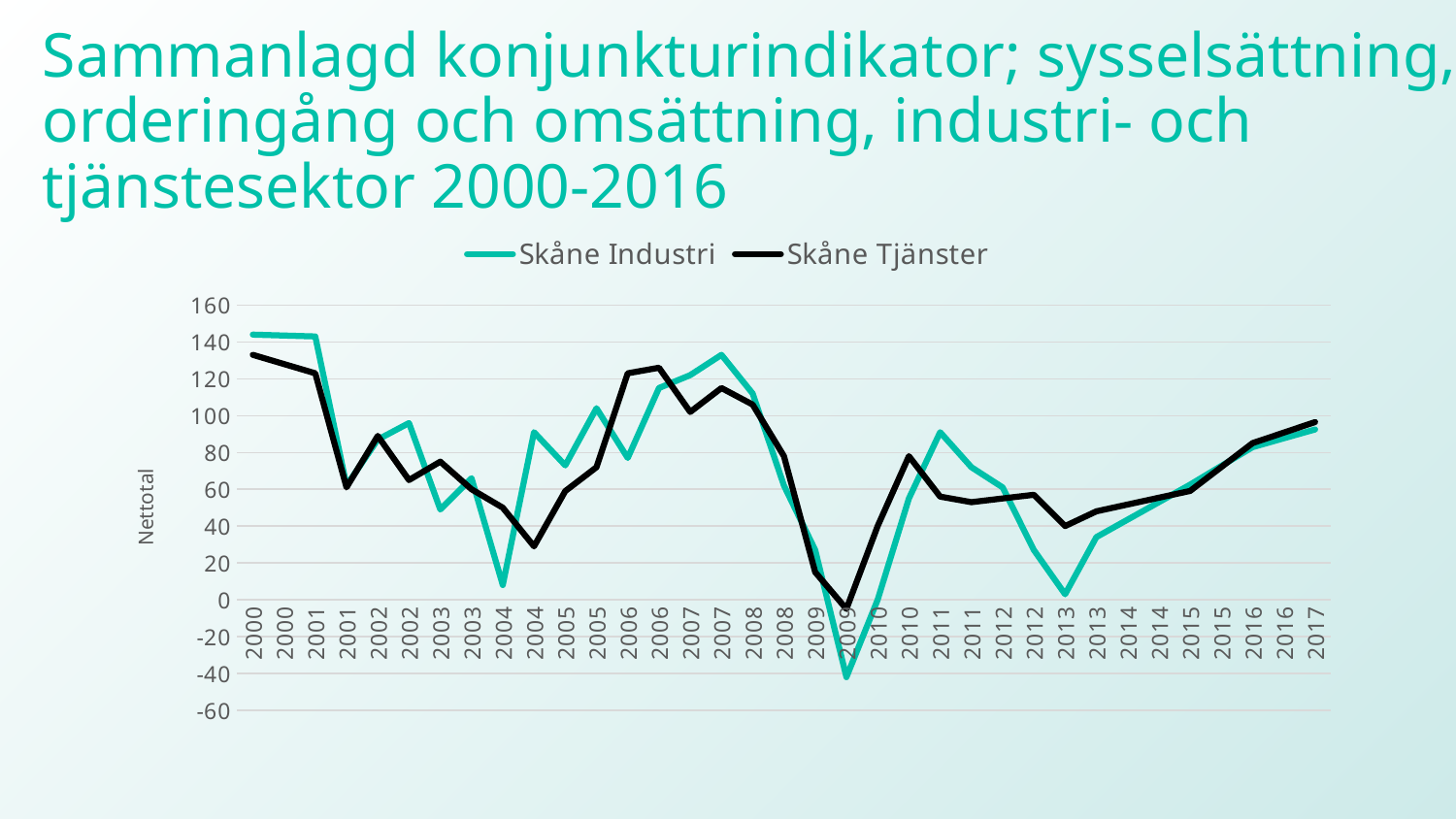
Is the value for Skåne Tjänster at the first 2000 point greater or less than 120? greater Is the value for Skåne Industri at the first 2013 point greater or less than 20? less At the second 2004 point, which series has the larger value, Skåne Industri or Skåne Tjänster? Skåne Industri What is the label on the vertical axis? Nettotal What kind of chart is shown on the slide? line chart Is the value for Skåne Industri at the second 2009 point greater or less than 0? less What are the two series named in the legend? Skåne Industri and Skåne Tjänster Do the values for Skåne Tjänster rise or fall from 2013 to 2017? rise At the first 2013 point, which series has the larger value, Skåne Industri or Skåne Tjänster? Skåne Tjänster How many series does the legend list? 2 In which year does Skåne Industri reach its lowest value? 2009